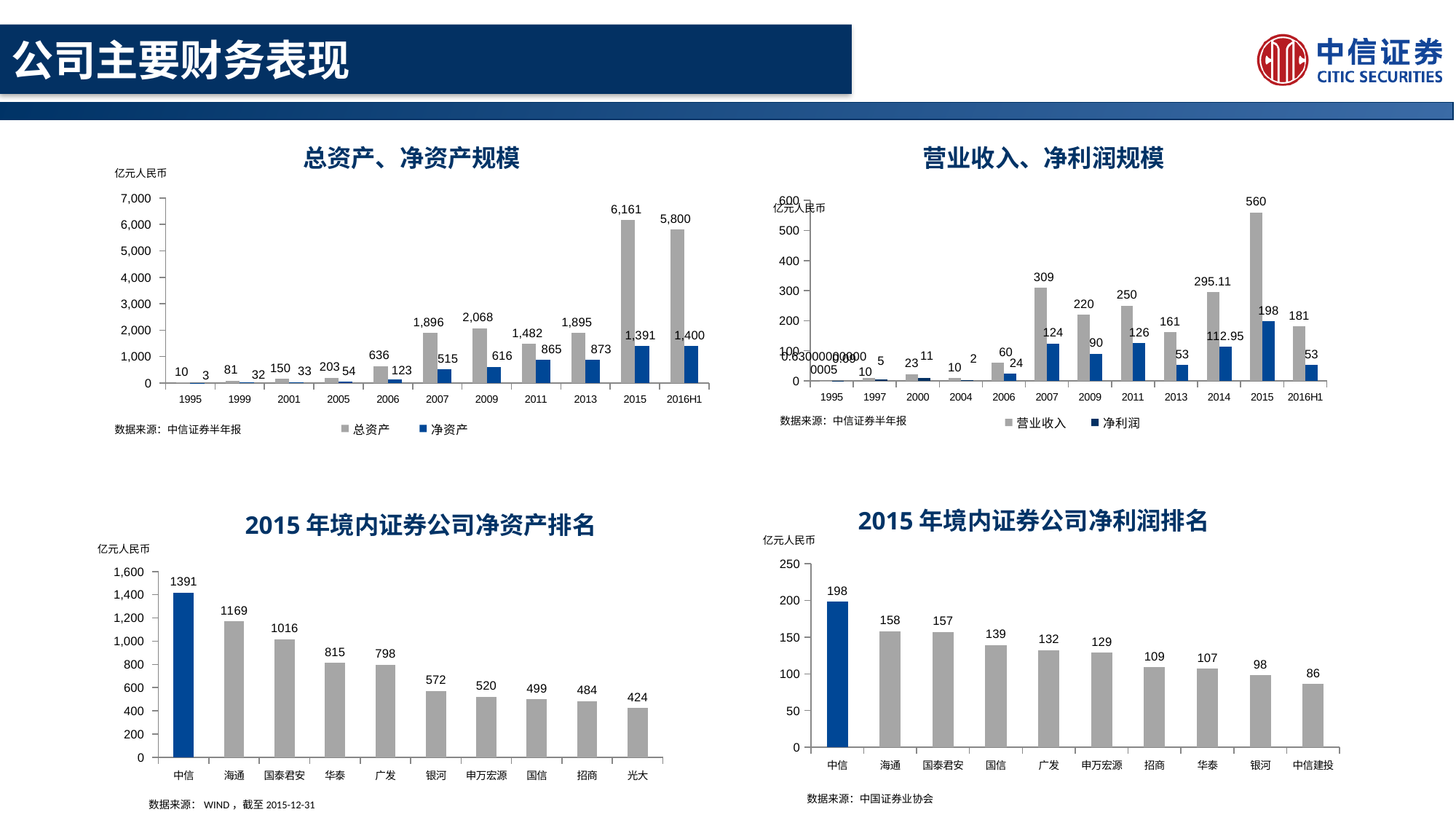
In the chart titled 营业收入、净利润规模, what is the 营业收入 value for 2014? 295.11 In the chart titled 营业收入、净利润规模, how many categories are shown on the x axis? 12 In the chart titled 2015 年境内证券公司净资产排名, which company has the lowest value? 光大 In the chart titled 总资产、净资产规模, what is the difference between 总资产 and 净资产 in 2013? 1,022 What kind of chart is the one titled 2015 年境内证券公司净利润排名? bar chart In the chart titled 营业收入、净利润规模, which year has the highest 净利润? 2015 In the chart titled 2015 年境内证券公司净利润排名, which is larger, the value for 国信 or the value for 广发? 国信 In the chart titled 2015 年境内证券公司净资产排名, what is the value for 华泰? 815 In the chart titled 总资产、净资产规模, how many series does the legend list? 2 In the chart titled 总资产、净资产规模, what is the 总资产 value for 2015? 6,161 In the chart titled 总资产、净资产规模, what is the 净资产 value for 2016H1? 1,400 In the chart titled 2015 年境内证券公司净资产排名, what is the difference between 中信 and 海通? 222